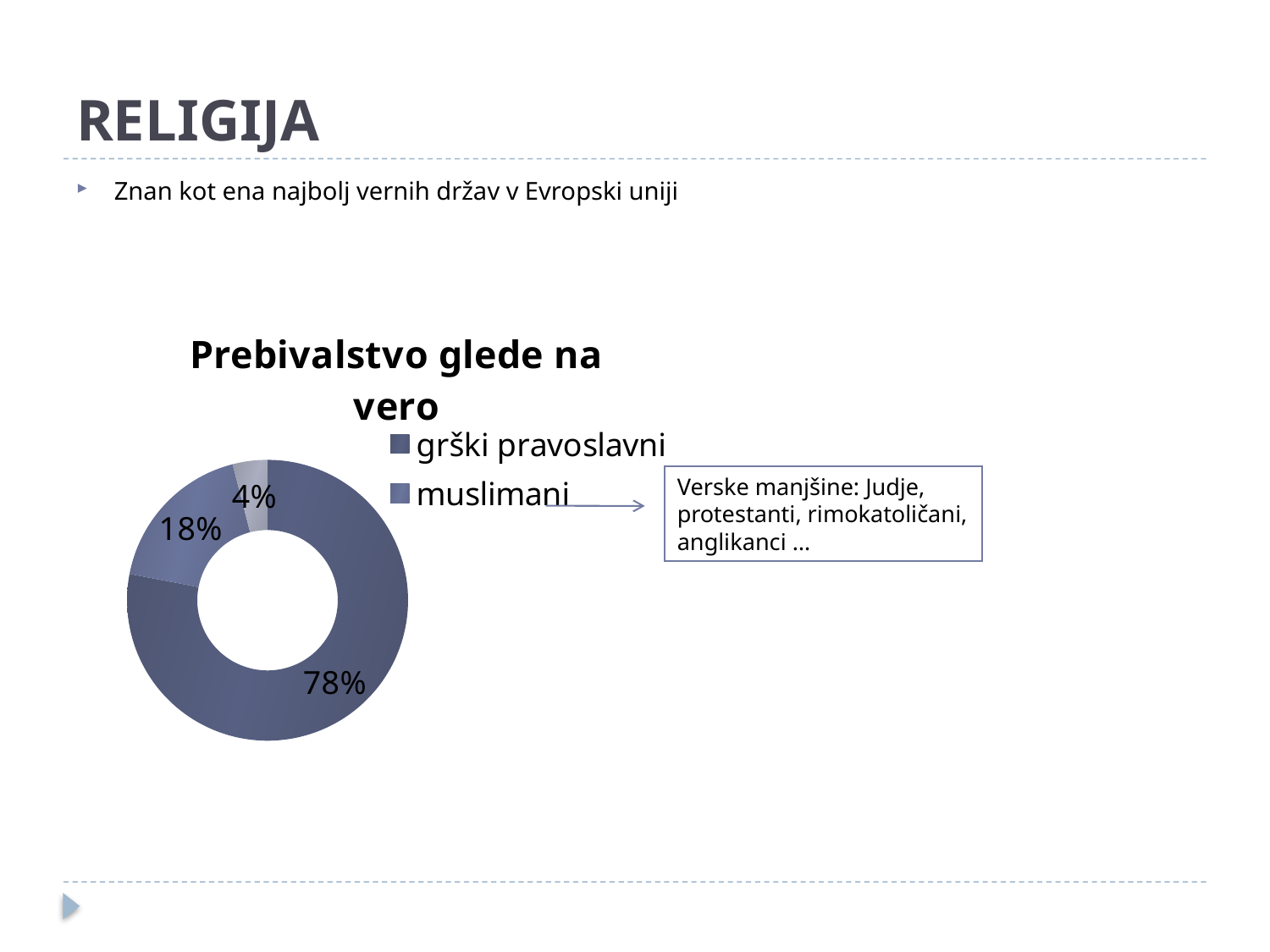
What percentage of the population is shown for grški pravoslavni in the chart? 78% What is the difference in percentage points between the grški pravoslavni slice and the muslimani slice? 60 percentage points What percentage of the population is shown for muslimani in the chart? 18% How many entries does the chart's legend list? 2 What is the title of the chart? Prebivalstvo glede na vero What do the three labelled slices of the chart add up to? 100% What kind of chart is shown on the slide? Doughnut chart How many slices does the chart have? 3 Which legend category has the largest slice in the chart? grški pravoslavni What share of the whole does the grški pravoslavni slice represent? 78% Which is larger, the slice for grški pravoslavni or the slice for muslimani? grški pravoslavni What is the value of the smallest slice in the chart? 4%